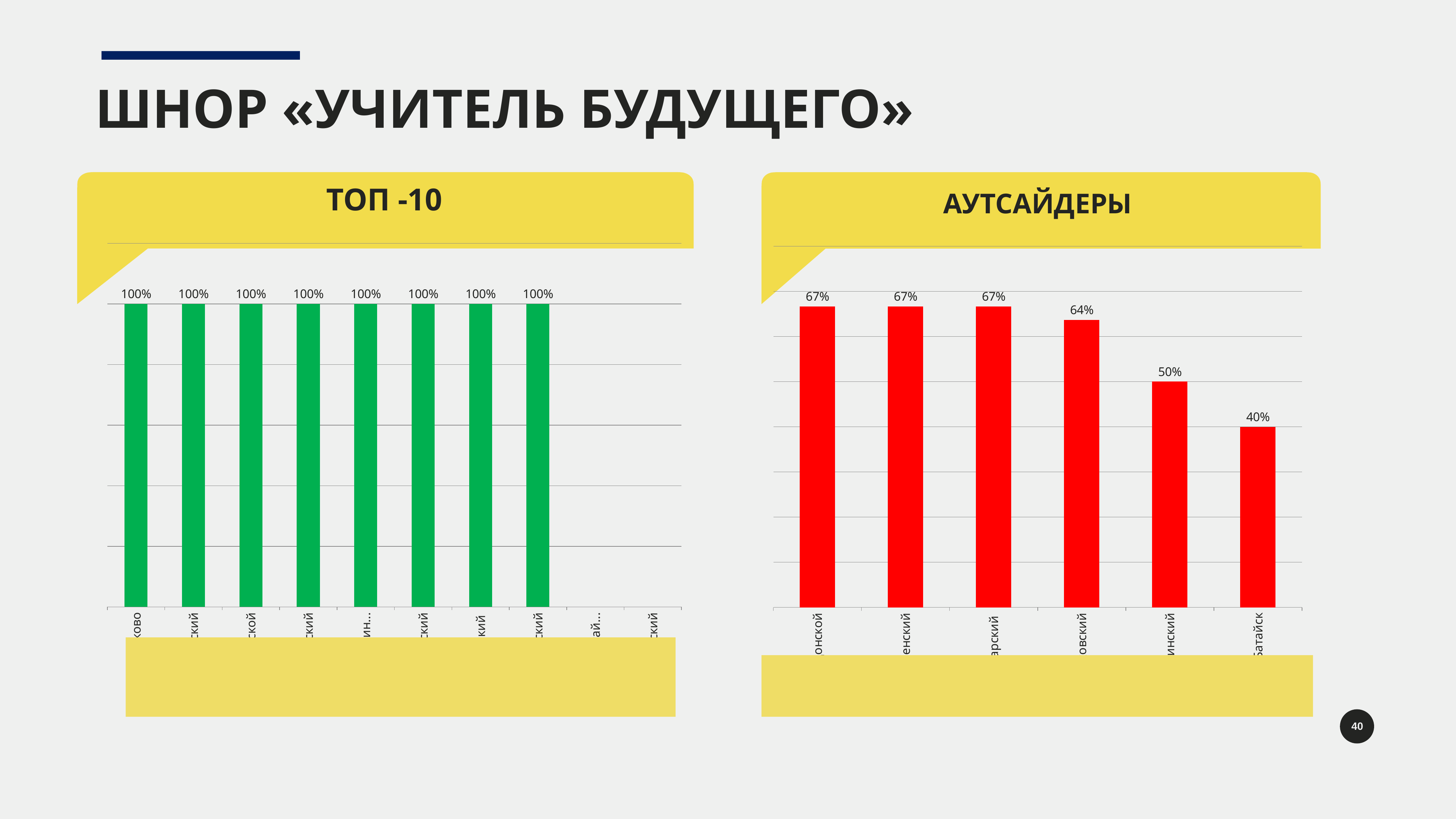
In the АУТСАЙДЕРЫ chart, which category has the lowest value? Батайск In the АУТСАЙДЕРЫ chart, what is the difference between the first bar and the fifth bar? 17% How many bars are plotted in the АУТСАЙДЕРЫ chart? 6 What type of chart is the АУТСАЙДЕРЫ chart? bar chart How many bars are plotted in the ТОП -10 chart? 8 In the АУТСАЙДЕРЫ chart, what is the value of the fifth bar from the left? 50% In the ТОП -10 chart, what value do all the plotted bars show? 100% In the АУТСАЙДЕРЫ chart, what is the value for Батайск? 40% In the АУТСАЙДЕРЫ chart, what is the difference between the fourth bar (64%) and Батайск (40%)? 24% In the АУТСАЙДЕРЫ chart, which is larger: the fourth bar or the fifth bar? the fourth bar In the АУТСАЙДЕРЫ chart, what is the value of the first (leftmost) bar? 67% In the АУТСАЙДЕРЫ chart, what is the value of the fourth bar from the left? 64%